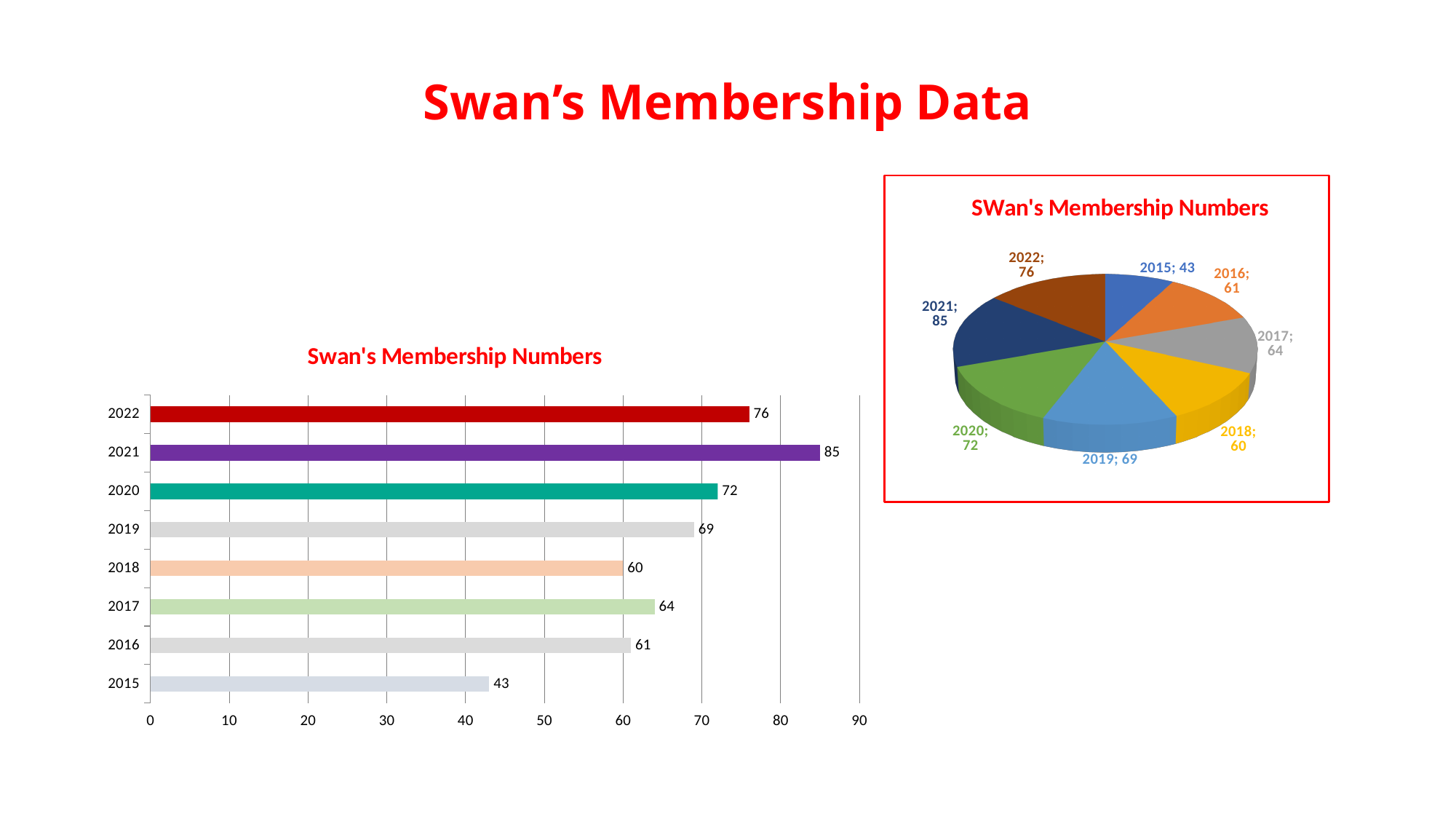
In the bar chart on the left, what is the total membership across all years shown? 530 What kind of chart is the chart on the right of the slide? pie chart In the bar chart on the left, which year has the highest membership number? 2021 In the bar chart on the left, what is the membership number for 2019? 69 How many years are shown in the bar chart on the left? 8 In the bar chart on the left, what is the difference between the membership numbers for 2021 and 2022? 9 In the pie chart on the right, which is larger, the value for 2017 or the value for 2018? 2017 What kind of chart is the chart on the left of the slide? bar chart In the bar chart on the left, which year has the lowest membership number? 2015 In the bar chart on the left, is the value for 2020 greater or less than 70? greater What is the title of the chart on the right of the slide? SWan's Membership Numbers In the pie chart on the right, what value is shown for 2016? 61